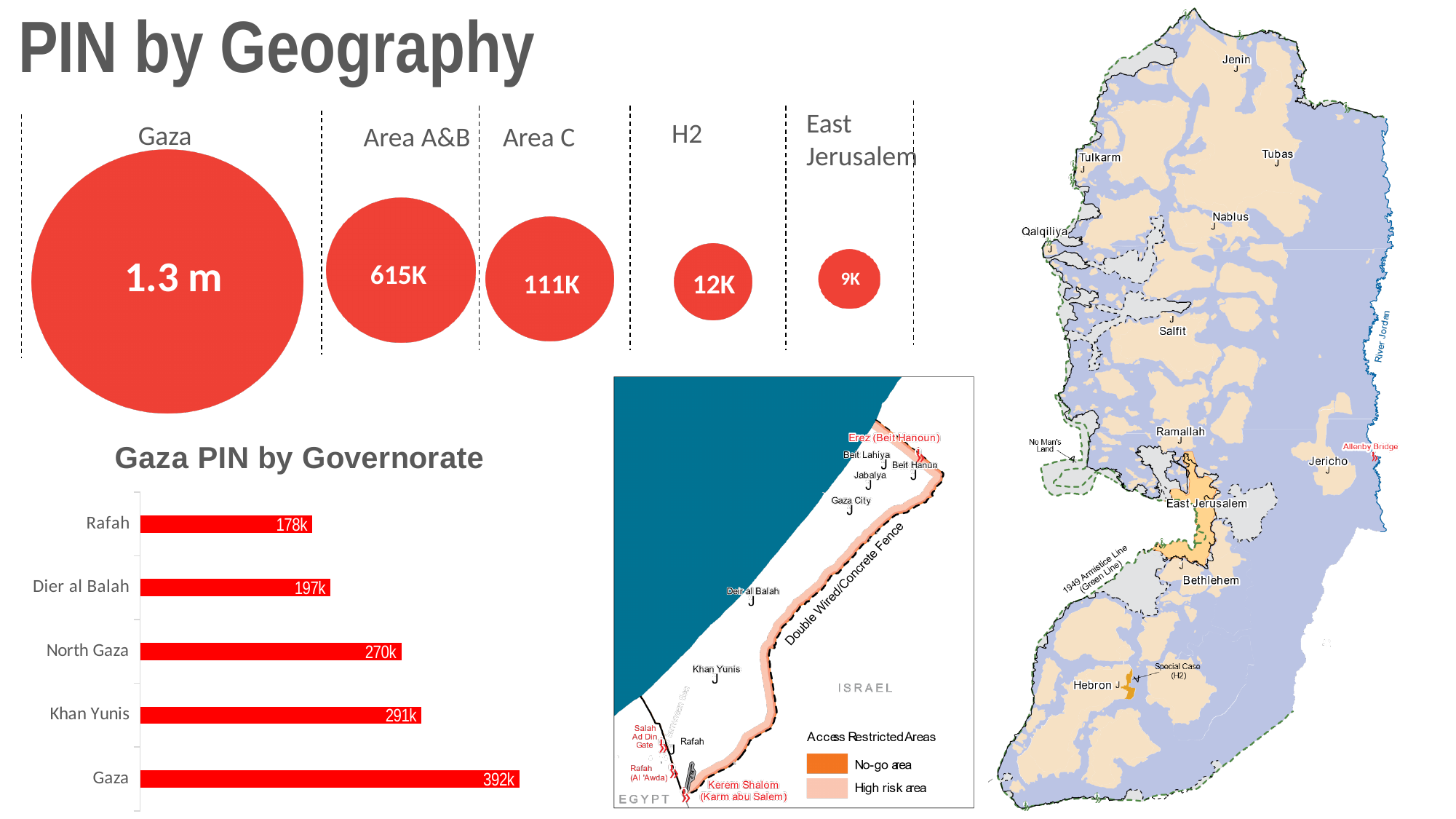
In the 'Gaza PIN by Governorate' bar chart, which is larger, the value for North Gaza or the value for Dier al Balah? North Gaza In the 'Gaza PIN by Governorate' bar chart, what is the value for Khan Yunis? 291k In the 'Gaza PIN by Governorate' bar chart, which governorate has the highest value? Gaza In the 'Gaza PIN by Governorate' bar chart, which governorate has the lowest value? Rafah In the 'Gaza PIN by Governorate' bar chart, what is the value for Dier al Balah? 197k In the bubble chart at the top of the slide, what is the PIN value shown for East Jerusalem? 9K In the bubble chart at the top of the slide, what is the PIN value shown for Area A&B? 615K In the bubble chart at the top of the slide, what is the difference between the values for Area C and H2? 99K How many governorates are shown in the 'Gaza PIN by Governorate' bar chart? 5 What kind of chart is 'Gaza PIN by Governorate'? Bar chart In the 'Gaza PIN by Governorate' bar chart, what is the difference between the values for Gaza and Khan Yunis? 101k In the bubble chart at the top of the slide, which geography has the largest PIN value? Gaza